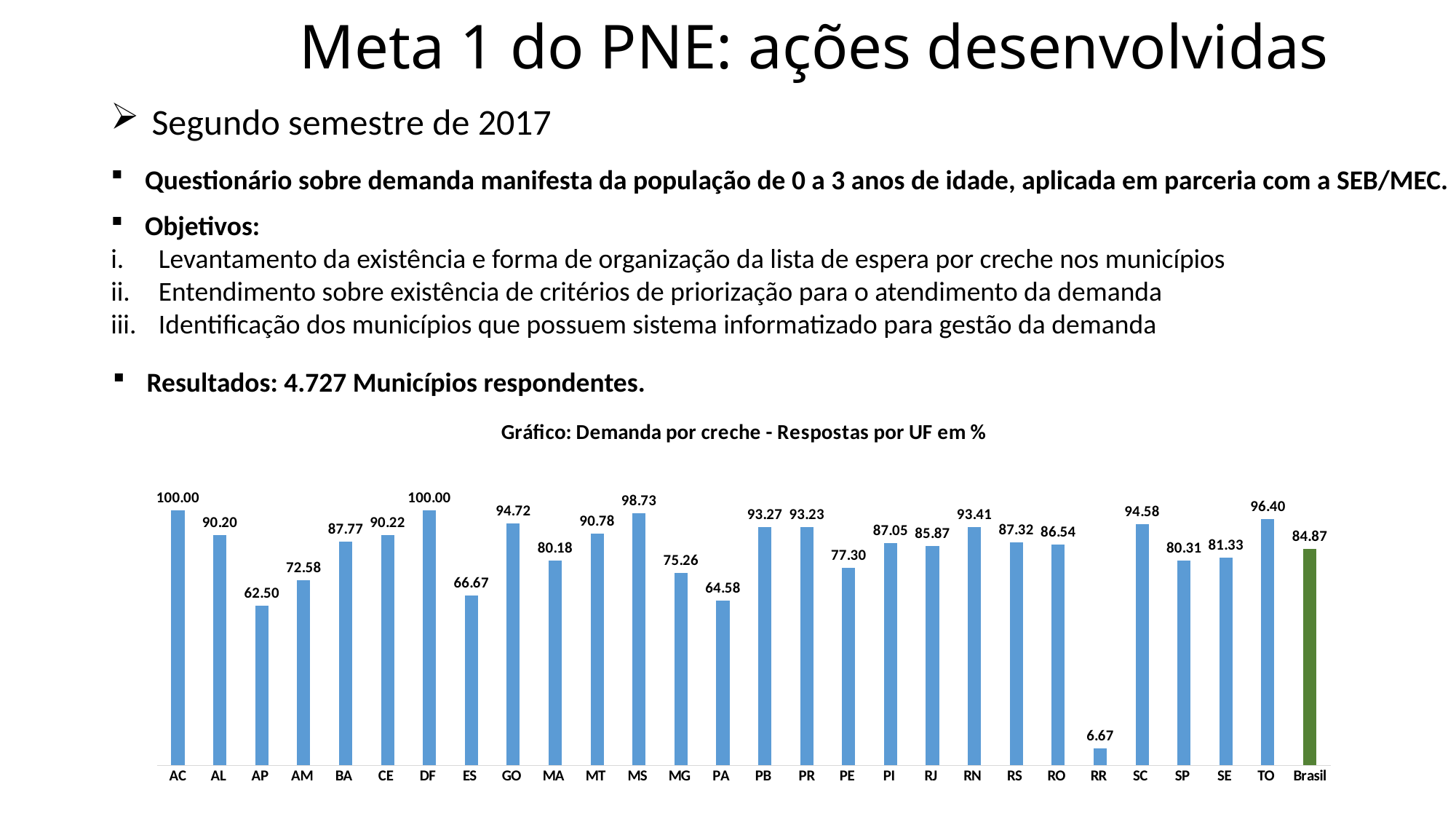
What is the value for Brasil in the chart? 84.87 How many bars are plotted in the chart? 28 What is the value for RR in the chart? 6.67 What is the title of the chart? Gráfico: Demanda por creche - Respostas por UF em % Which is larger, the value for AP or the value for ES? ES What kind of chart is shown on the slide? Bar chart What is the value for MS in the chart? 98.73 Which bar in the chart is coloured green instead of blue? Brasil Which is larger, the value for GO or the value for MG? GO What is the difference between the values for TO and SP? 16.09 Which two UFs share the highest value of 100.00 in the chart? AC and DF Which UF has the lowest value in the chart? RR